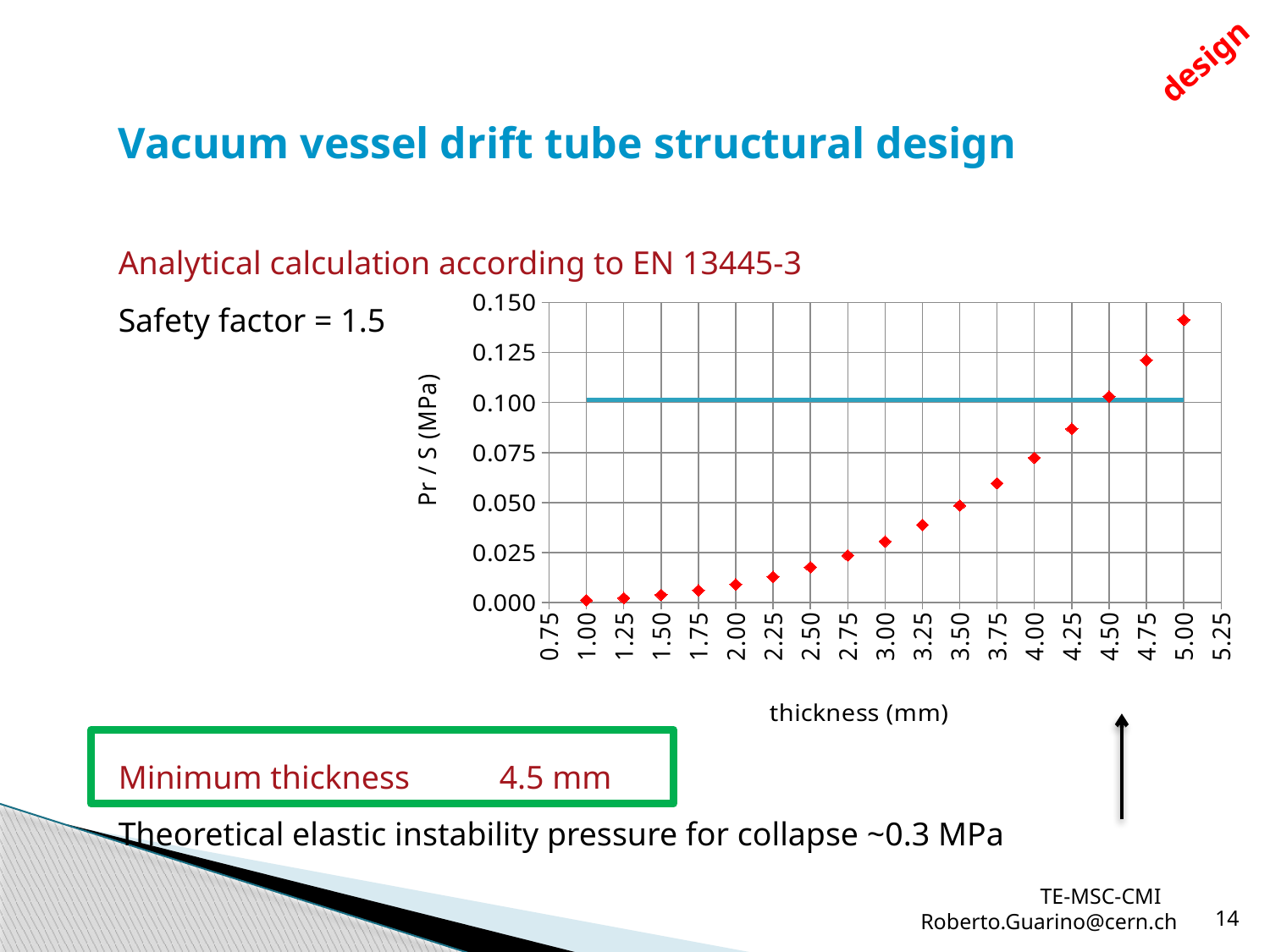
At which thickness is the plotted Pr / S value highest? 5.00 How many red data points are plotted on the chart? 17 What kind of chart is shown on the slide? scatter chart Is the value for thickness 5.00 greater or less than 0.125? greater What is the label of the x axis of the chart? thickness (mm) Do the plotted values rise or fall as thickness increases along the x axis? rise Which has the larger Pr / S value, thickness 4.50 or thickness 3.00? 4.50 Is the value for thickness 2.00 greater or less than 0.025? less At which thickness is the plotted Pr / S value lowest? 1.00 Is the value for thickness 4.25 greater or less than 0.075? greater What is the label of the y axis of the chart? Pr / S (MPa)